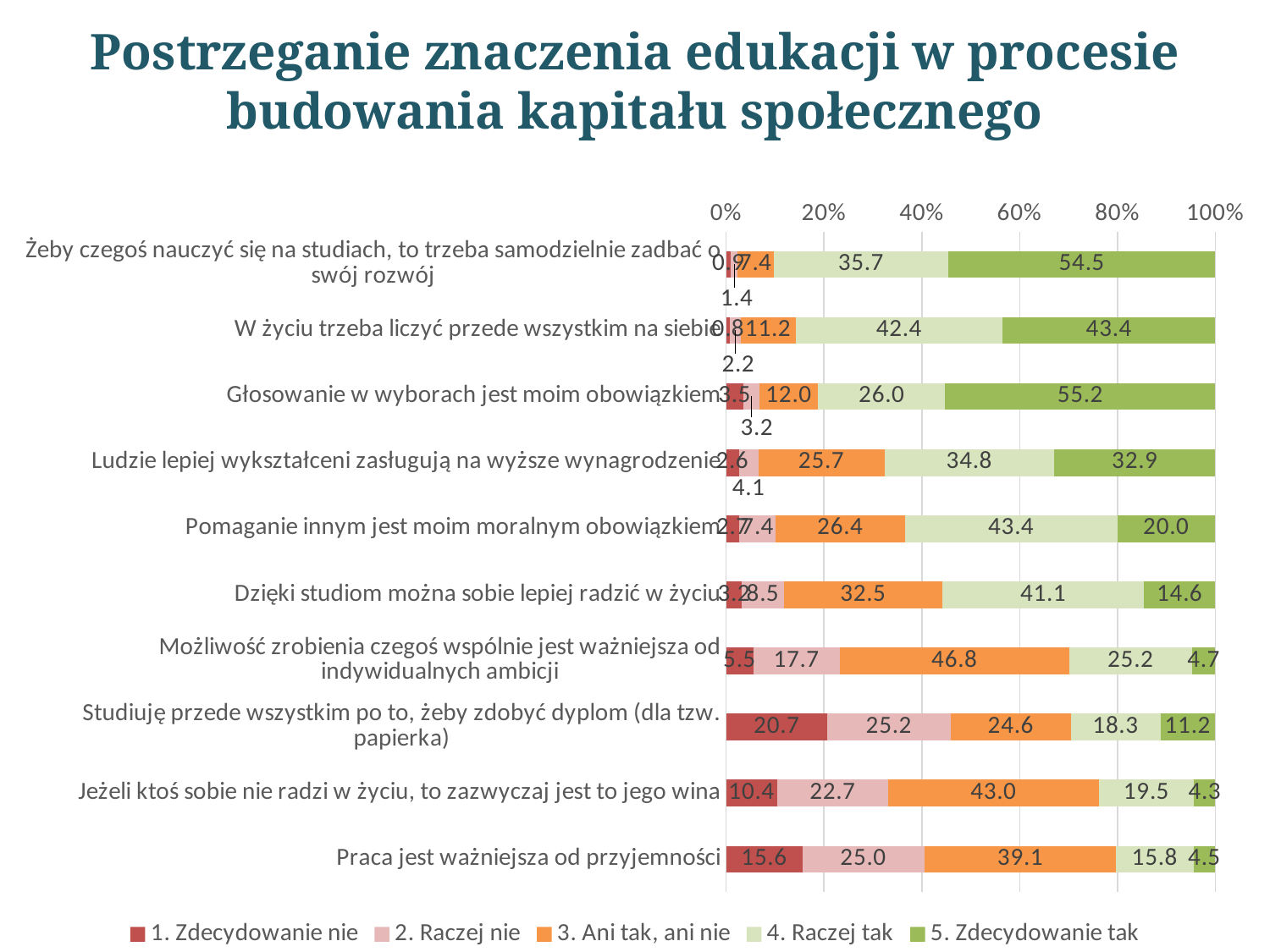
What is the title of the chart on the slide? Postrzeganie znaczenia edukacji w procesie budowania kapitału społecznego What is the value of "3. Ani tak, ani nie" for "Możliwość zrobienia czegoś wspólnie jest ważniejsza od indywidualnych ambicji"? 46.8 What type of chart is shown on the slide? stacked bar chart Which is larger: the "3. Ani tak, ani nie" value for "Jeżeli ktoś sobie nie radzi w życiu, to zazwyczaj jest to jego wina" or for "Praca jest ważniejsza od przyjemności"? Jeżeli ktoś sobie nie radzi w życiu, to zazwyczaj jest to jego wina What is the value of "4. Raczej tak" for "Praca jest ważniejsza od przyjemności"? 15.8 What is the difference between the "5. Zdecydowanie tak" values for "Żeby czegoś nauczyć się na studiach, to trzeba samodzielnie zadbać o swój rozwój" and "W życiu trzeba liczyć przede wszystkim na siebie"? 11.1 What is the value of "1. Zdecydowanie nie" for "Studiuję przede wszystkim po to, żeby zdobyć dyplom (dla tzw. papierka)"? 20.7 How many statements (categories) are plotted in the chart? 10 Which statement has the highest value for "1. Zdecydowanie nie"? Studiuję przede wszystkim po to, żeby zdobyć dyplom (dla tzw. papierka) What is the value of "5. Zdecydowanie tak" for "Głosowanie w wyborach jest moim obowiązkiem"? 55.2 How many series does the legend list? 5 Which statement has the highest value for "5. Zdecydowanie tak"? Głosowanie w wyborach jest moim obowiązkiem